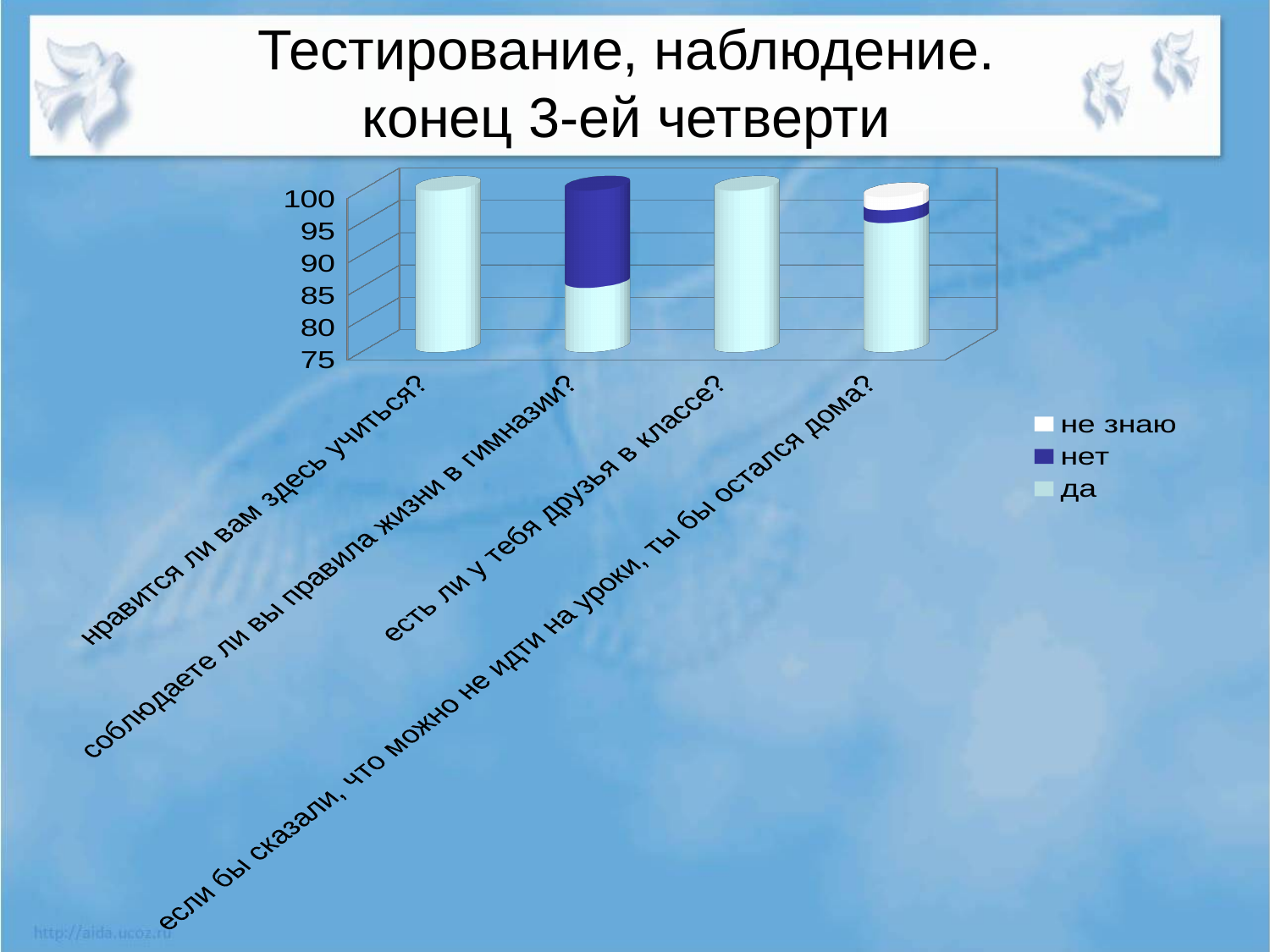
Is the value of "да" for "если бы сказали, что можно не идти на уроки, ты бы остался дома?" greater or less than 90? greater Which category has the smallest "да" value? соблюдаете ли вы правила жизни в гимназии? Is the value of "да" for "есть ли у тебя друзья в классе?" greater or less than 95? greater How many categories (questions) are shown on the x axis of the chart? 4 Is the value of "да" for "соблюдаете ли вы правила жизни в гимназии?" greater or less than 80? greater Which category has the largest "нет" segment? соблюдаете ли вы правила жизни в гимназии? What kind of chart is shown on the slide? bar chart Which is larger: the "да" value for "нравится ли вам здесь учиться?" or for "соблюдаете ли вы правила жизни в гимназии?"? нравится ли вам здесь учиться? Which series is shown in dark blue in the legend? нет How many series does the chart's legend list? 3